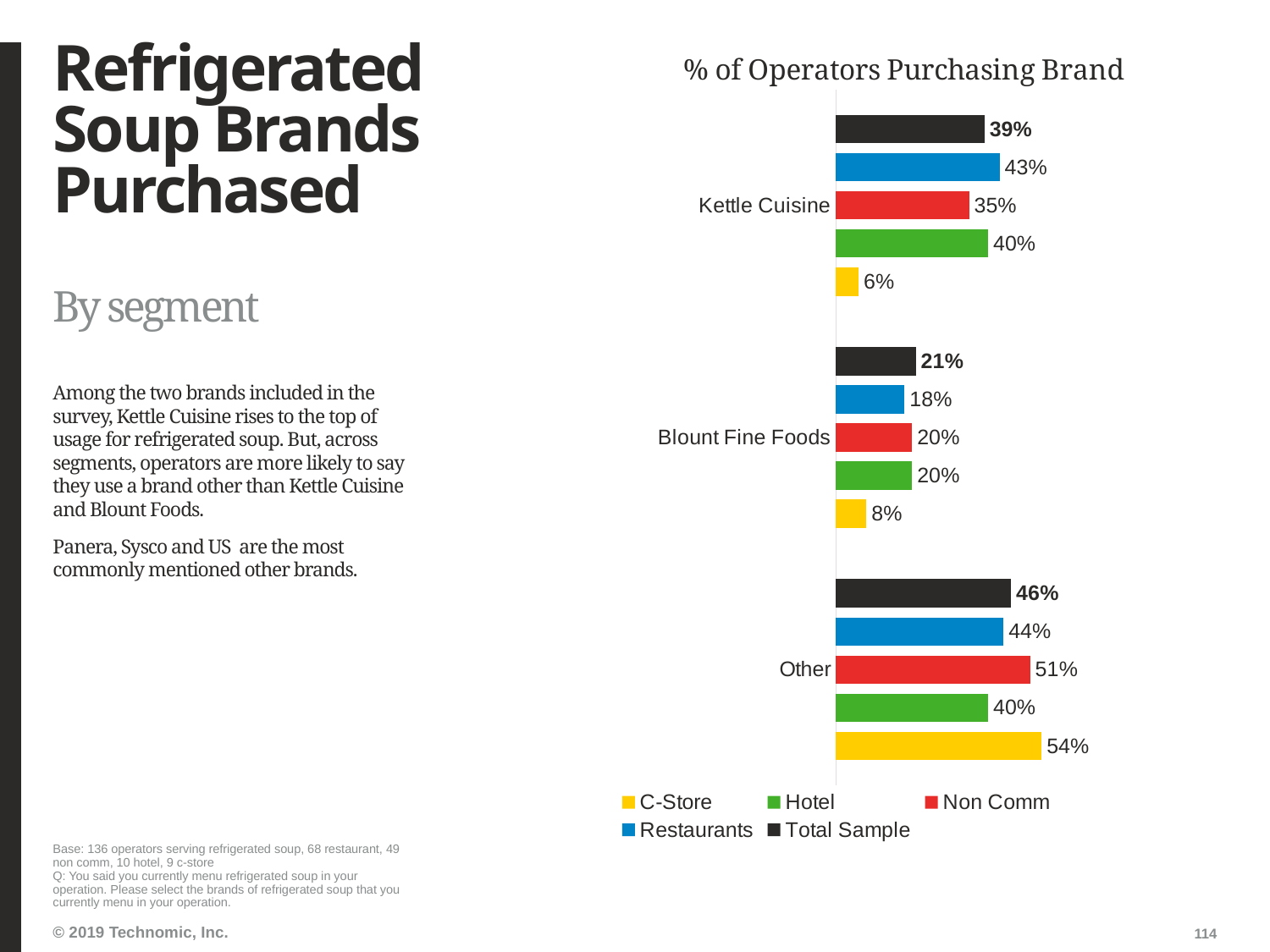
What is the difference between the Restaurants and Non Comm values for Kettle Cuisine? 8% How many brand categories are shown on the chart? 3 What kind of chart is shown on the slide? Bar chart How many series does the legend list? 5 What percentage of the Total Sample purchases Kettle Cuisine? 39% What is the title of the chart? % of Operators Purchasing Brand Which segment has the lowest value for Kettle Cuisine? C-Store Which is larger for Blount Fine Foods: the Total Sample value or the Restaurants value? Total Sample Which segment has the highest value for Other? C-Store What percentage of Restaurants purchase Kettle Cuisine? 43% What percentage of C-Store operators purchase Blount Fine Foods? 8% What percentage of Non Comm operators purchase a brand in the Other category? 51%